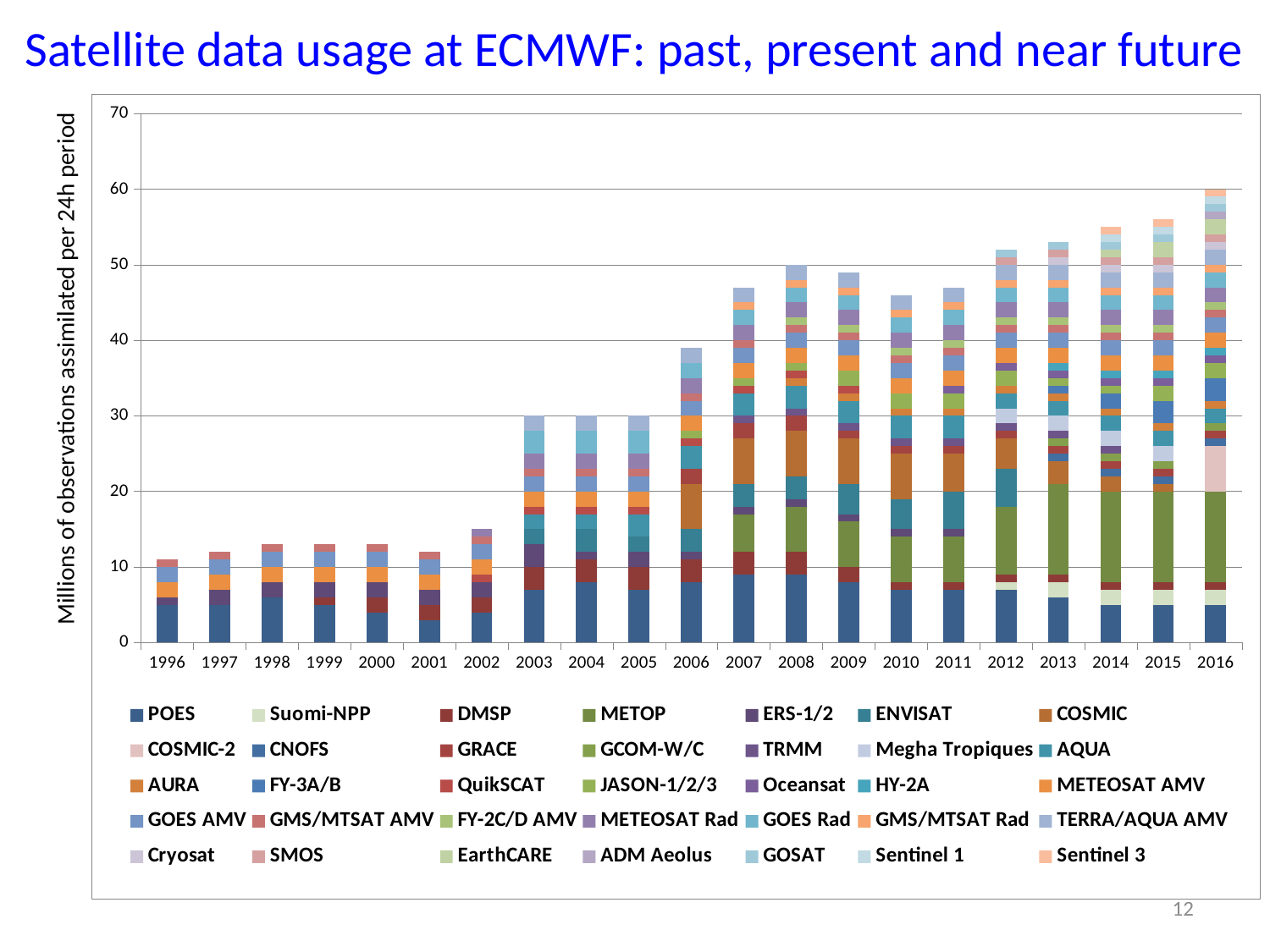
What is the total height of the stacked bar for 2008? 50 What is the total height of the stacked bar for 2016, in millions of observations per 24h period? 60 Which year has the larger total, 2013 or 2006? 2013 What is the label on the vertical axis of the chart? Millions of observations assimilated per 24h period How many years are shown along the x axis of the chart? 21 What is the total height of the stacked bar for 2003? 30 Is the total for 2010 greater or less than 50? less Is the total for 2007 greater or less than 40? greater Do the total observations assimilated generally rise or fall from 1996 to 2016? Rise Which year has the highest total of observations assimilated? 2016 What kind of chart is shown on the slide? Stacked bar chart How many series does the chart's legend list? 35